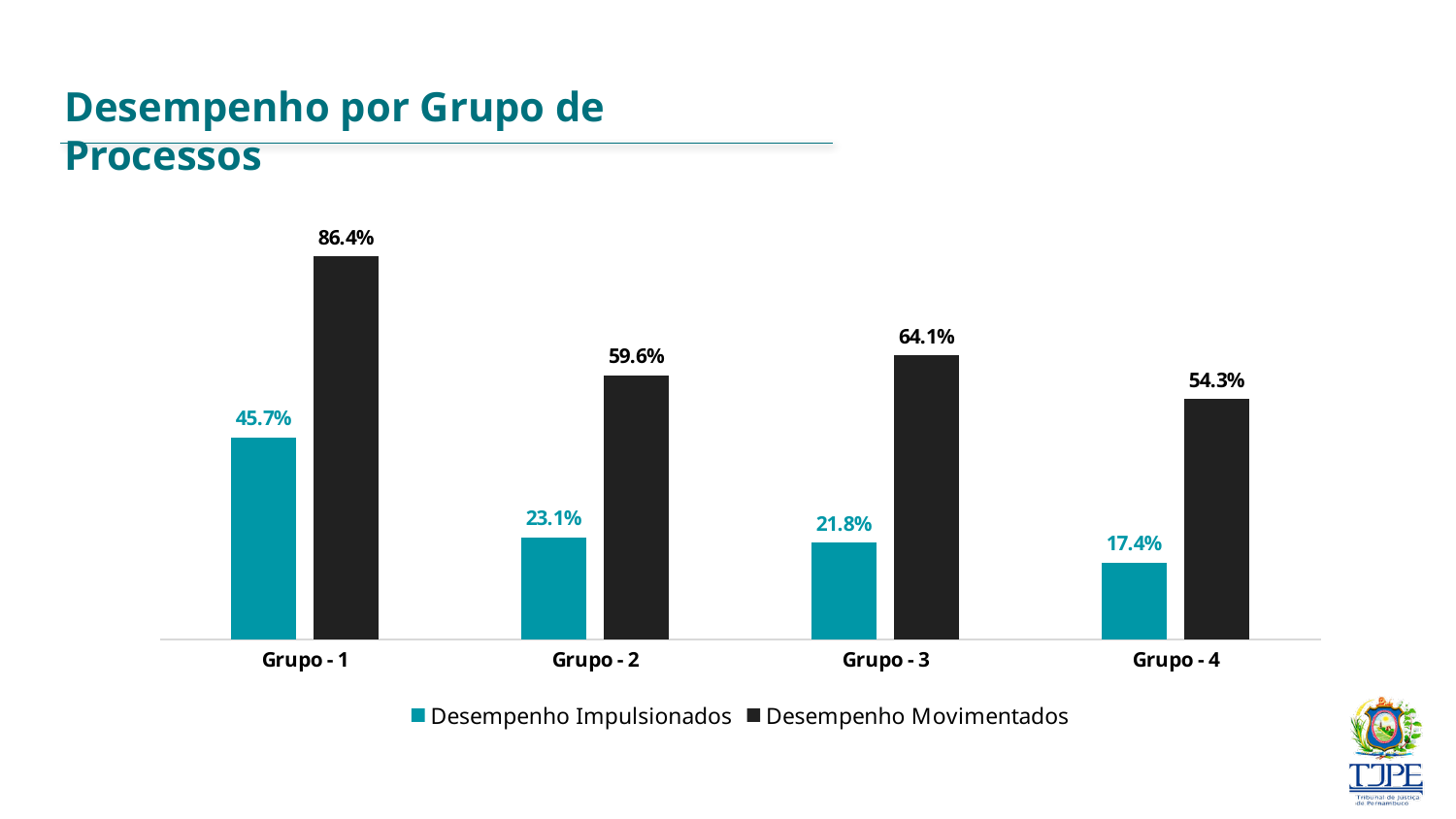
How many groups are shown on the x axis? 4 What is the value of Desempenho Movimentados for Grupo - 3? 64.1% What is the difference between Desempenho Movimentados and Desempenho Impulsionados for Grupo - 2? 36.5% Which group has the highest Desempenho Movimentados value? Grupo - 1 What is the title of the slide? Desempenho por Grupo de Processos Which is larger: Desempenho Movimentados for Grupo - 3 or for Grupo - 4? Grupo - 3 What kind of chart is shown on the slide? Bar chart Which series is shown in teal (blue-green) bars? Desempenho Impulsionados How many series does the legend list? 2 Which group has the lowest Desempenho Impulsionados value? Grupo - 4 What is the value of Desempenho Impulsionados for Grupo - 4? 17.4% What is the value of Desempenho Impulsionados for Grupo - 1? 45.7%